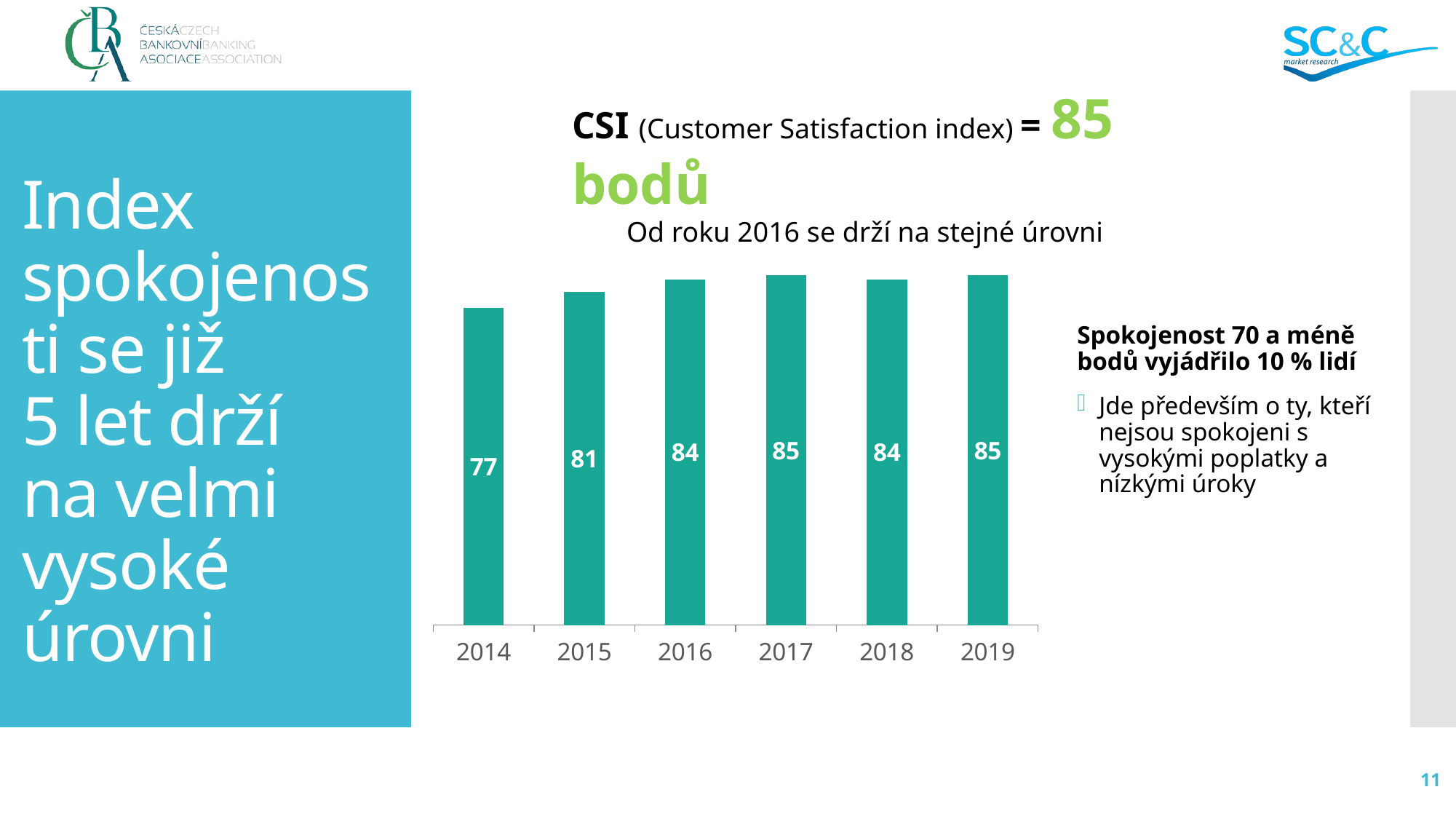
Which is larger, the CSI value for 2015 or for 2016? 2016 What is the first year shown on the x axis of the chart? 2014 What kind of chart is shown on the slide? bar chart What is the difference between the CSI values for 2016 and 2015? 3 What is the CSI value shown for 2014? 77 What is the CSI value shown for 2019? 85 What is the difference between the CSI values for 2019 and 2014? 8 Do the CSI values generally rise or fall from 2014 to 2017? rise What is the CSI value shown for 2015? 81 How many years are shown on the x axis of the chart? 6 Which year has the lowest CSI value in the chart? 2014 What is the CSI value shown for 2018? 84